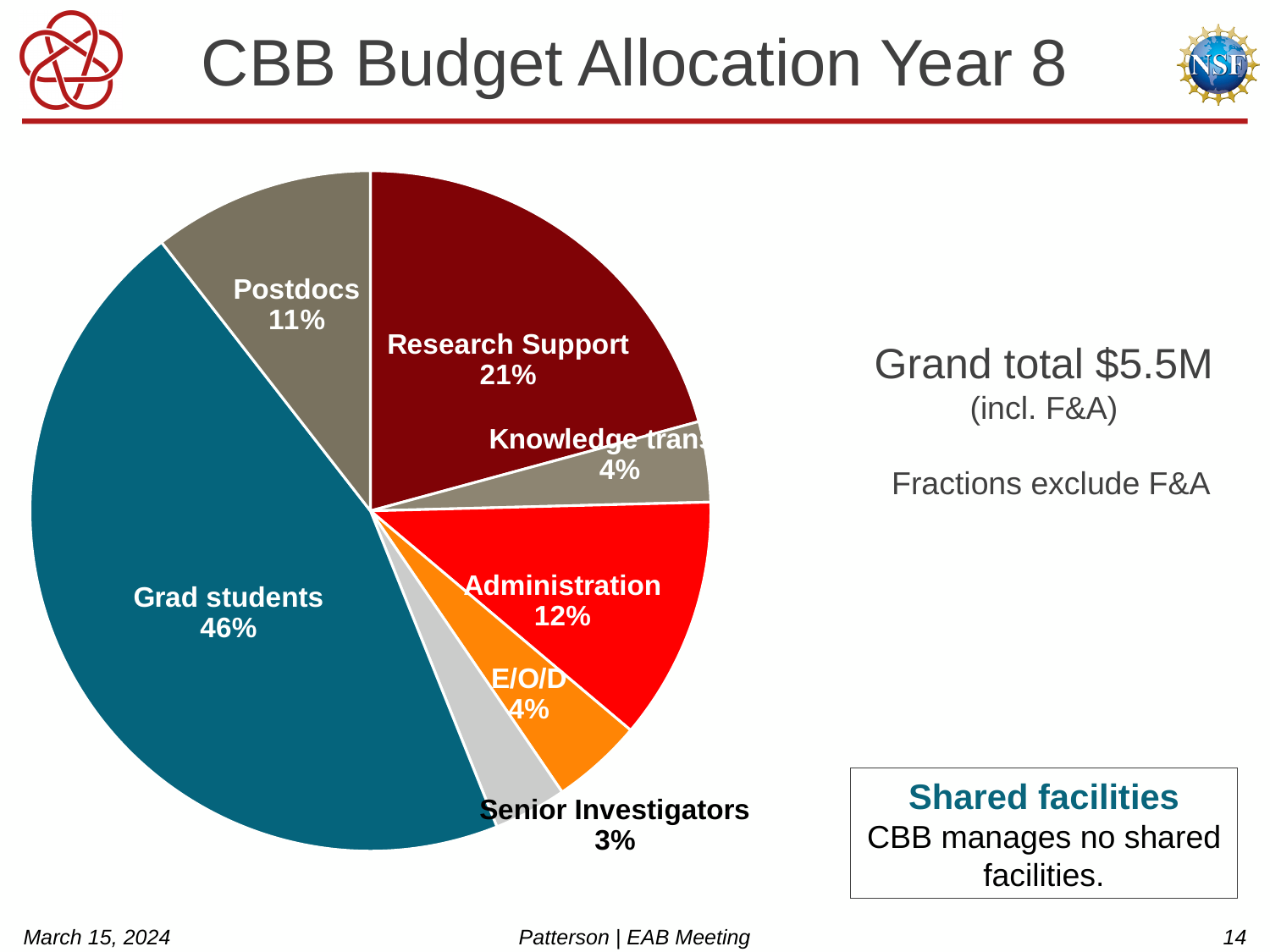
What is the title of the slide containing the pie chart? CBB Budget Allocation Year 8 Which is larger, the Administration share or the Postdocs share? Administration What kind of chart is shown on the slide? pie chart Which category has the largest slice of the pie? Grad students How many percentage points larger is the Grad students share than the Research Support share? 25 percentage points What percentage is shown for Senior Investigators? 3% Which category has the smallest slice of the pie? Senior Investigators What percentage is shown for Postdocs? 11% How many slices does the pie chart have? 7 What percentage is shown for Research Support? 21% What percentage is shown for Administration? 12% What share of the CBB Year 8 budget goes to Grad students? 46%